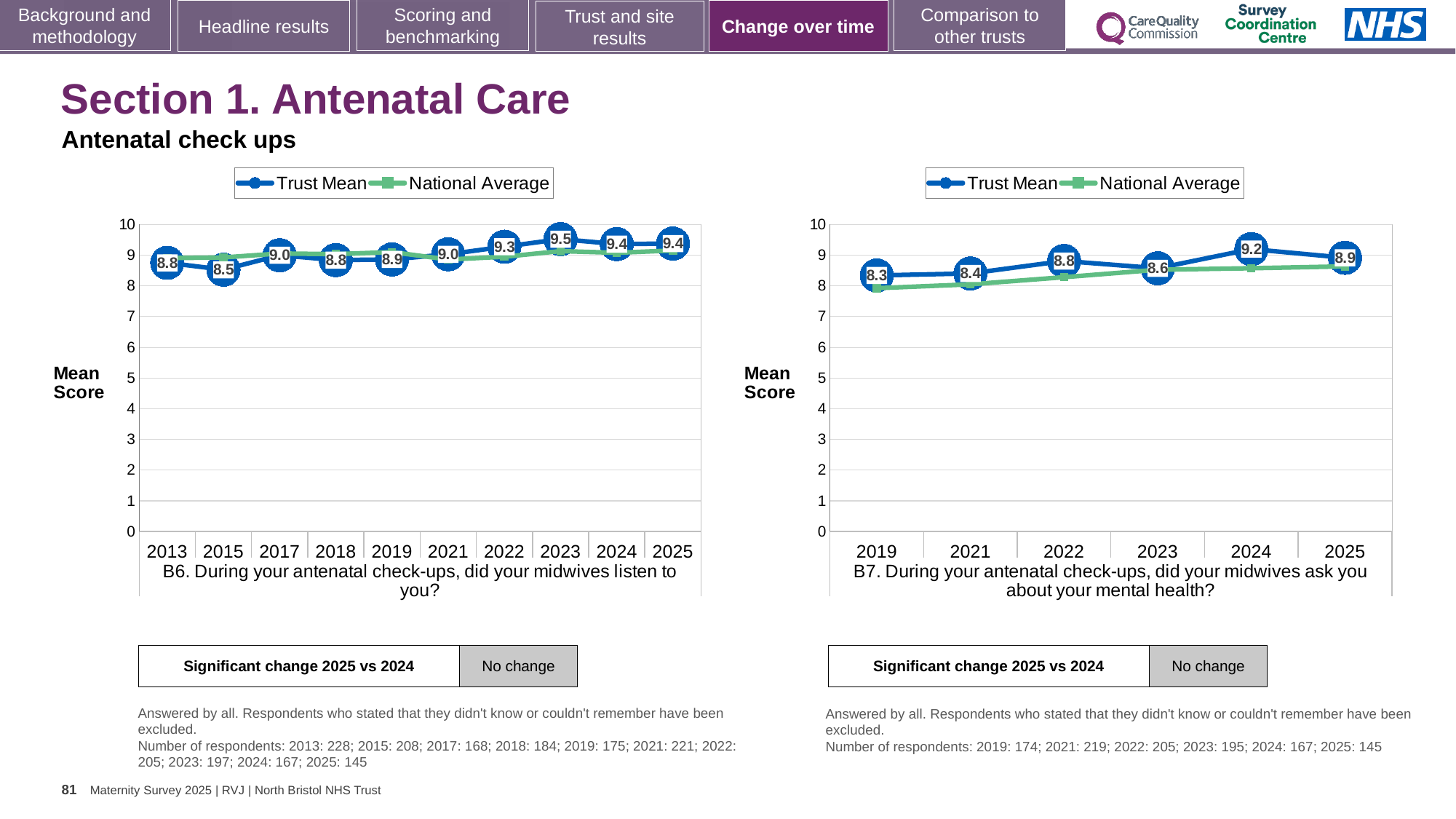
In the B7 chart (right), is the Trust Mean score higher in 2022 or in 2023? 2022 In the B6 chart (left), what is the Trust Mean score for 2023? 9.5 In the B7 chart (right), which year has the highest Trust Mean score? 2024 In the B7 chart (right), what is the Trust Mean score for 2024? 9.2 What kind of chart is the B7 chart (right)? Line chart In the B7 chart (right), what is the difference between the Trust Mean scores for 2024 and 2019? 0.9 In the B7 chart (right), does the Trust Mean score generally rise or fall from 2019 to 2025? Rise In the B6 chart (left), what is the difference between the Trust Mean scores for 2023 and 2015? 1.0 In the B6 chart (left), which year has the lowest Trust Mean score? 2015 How many years are plotted on the x axis of the B6 chart (left)? 10 In the B6 chart (left), is the Trust Mean value for 2025 greater or less than 9? greater How many series does the legend of the B7 chart (right) list? 2